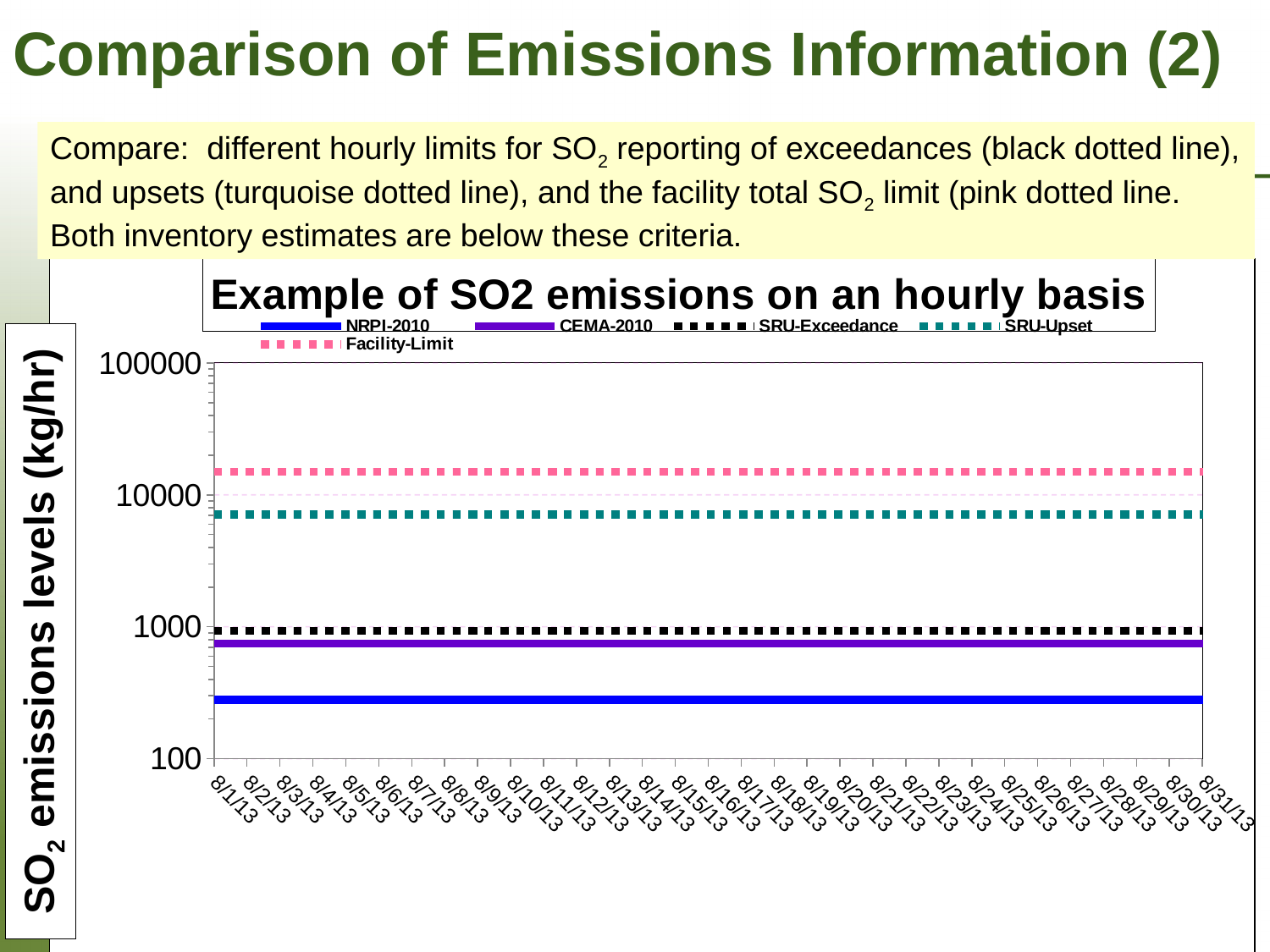
Do the NRPI-2010 values rise, fall, or stay constant across the dates on the x axis? stay constant Which series is larger, CEMA-2010 or NRPI-2010? CEMA-2010 Is the value for NRPI-2010 greater or less than 1000? less Is the value for SRU-Upset greater or less than 10000? less What kind of chart is shown on the slide? line chart Which series has the highest values on the chart? Facility-Limit Which series has the lowest values on the chart? NRPI-2010 How many series does the chart legend list? 5 What is the title of the chart? Example of SO2 emissions on an hourly basis Is the value for Facility-Limit greater or less than 10000? greater What is the label of the y axis of the chart? SO2 emissions levels (kg/hr) How many dates are shown along the x axis of the chart? 31